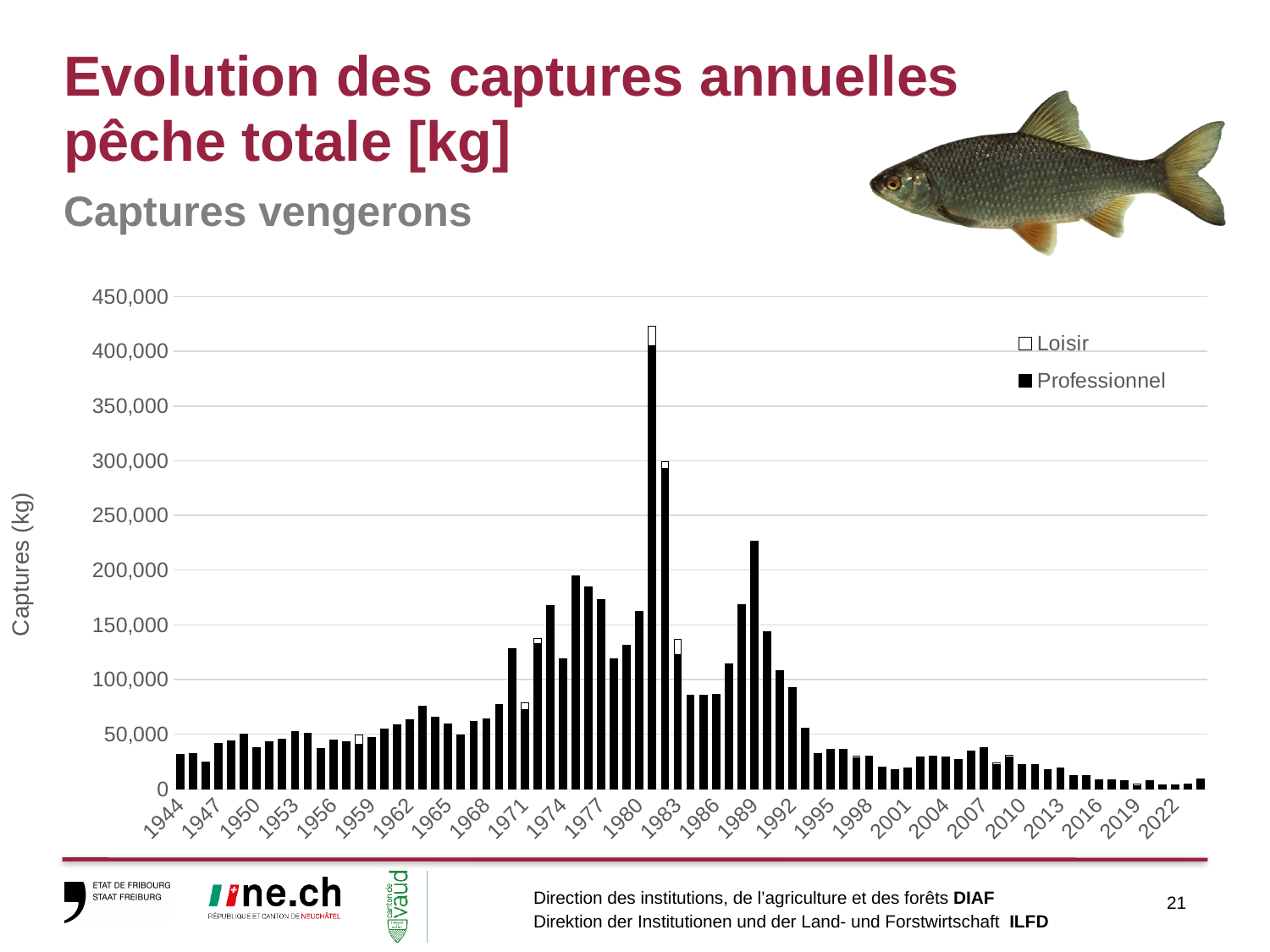
What is the label of the vertical axis? Captures (kg) Do the total catches generally rise or fall from 1992 to 2022? fall Is the total value for 1944 greater or less than 50,000? less What are the two series named in the legend? Loisir and Professionnel Is the total value for 2022 greater or less than 50,000? less Is the total value for 1989 greater or less than 200,000? greater Which year has the larger total catch, 1989 or 2022? 1989 Which year has the larger total catch, 1944 or 1980? 1980 What type of chart is shown on the slide? Stacked bar chart How many series does the legend list? 2